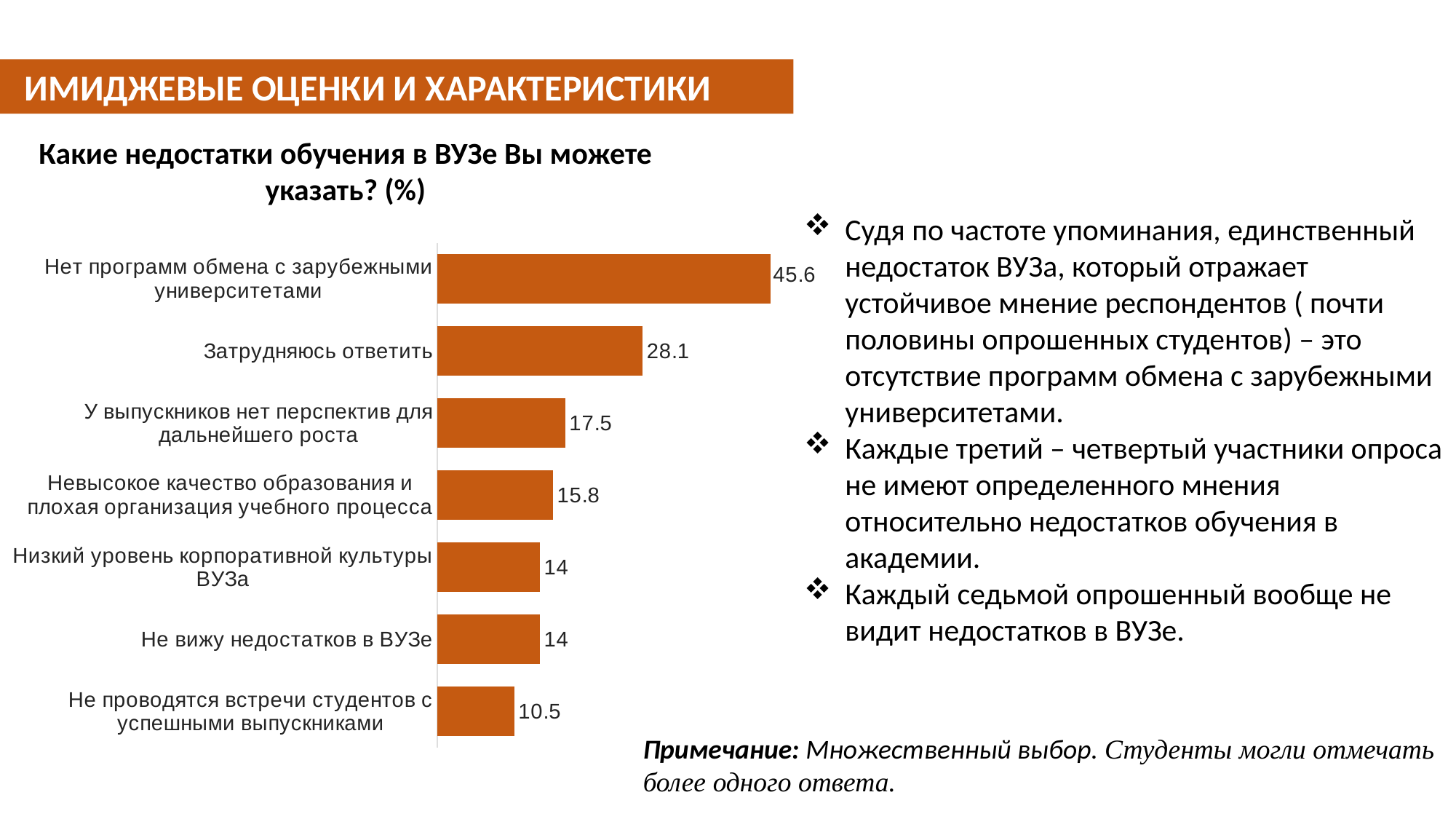
What is the title of the chart? Какие недостатки обучения в ВУЗе Вы можете указать? (%) What is the difference between the values for "Нет программ обмена с зарубежными университетами" and "Затрудняюсь ответить"? 17.5 What value is shown for "Затрудняюсь ответить"? 28.1 What value is shown for "Невысокое качество образования и плохая организация учебного процесса"? 15.8 Which category has the highest value? Нет программ обмена с зарубежными университетами Which category has the lowest value? Не проводятся встречи студентов с успешными выпускниками What value is shown for "Нет программ обмена с зарубежными университетами"? 45.6 How many categories are shown in the chart? 7 What kind of chart is shown on the slide? Bar chart What is the difference between the values for "У выпускников нет перспектив для дальнейшего роста" and "Невысокое качество образования и плохая организация учебного процесса"? 1.7 Which is larger: the value for "Затрудняюсь ответить" or the value for "У выпускников нет перспектив для дальнейшего роста"? Затрудняюсь ответить What value is shown for "Не проводятся встречи студентов с успешными выпускниками"? 10.5